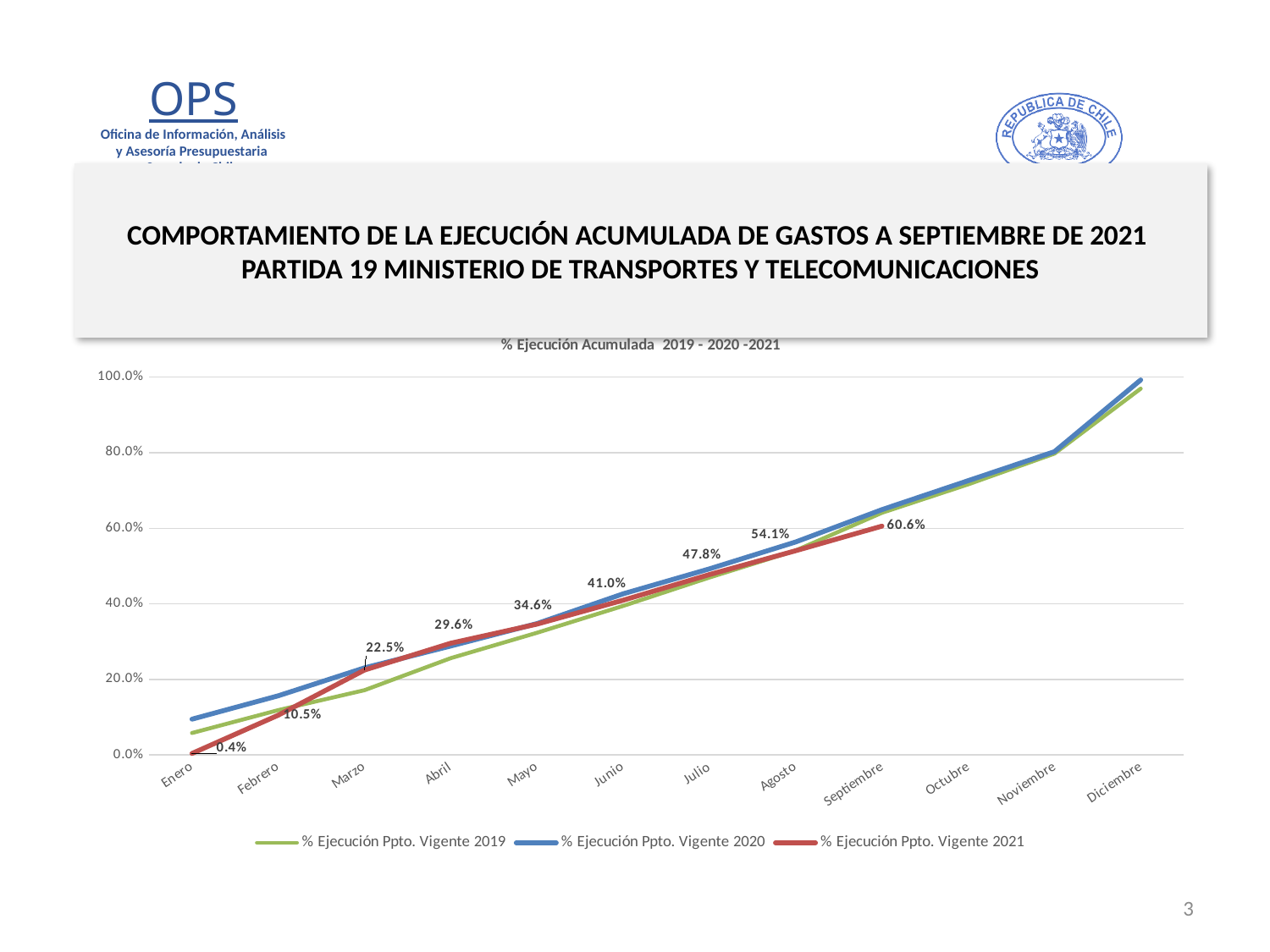
Which month has the lowest value for % Ejecución Ppto. Vigente 2021? Enero What is the value for % Ejecución Ppto. Vigente 2021 in Julio? 47.8% What is the value for % Ejecución Ppto. Vigente 2021 in Mayo? 34.6% What is the value for % Ejecución Ppto. Vigente 2021 in Septiembre? 60.6% What is the difference between the % Ejecución Ppto. Vigente 2021 values for Agosto and Julio? 6.3% What is the value for % Ejecución Ppto. Vigente 2021 in Enero? 0.4% Which month has the highest value for % Ejecución Ppto. Vigente 2021? Septiembre Do the values for % Ejecución Ppto. Vigente 2021 rise or fall from Enero to Septiembre? rise In Enero, which series is larger: % Ejecución Ppto. Vigente 2020 or % Ejecución Ppto. Vigente 2021? % Ejecución Ppto. Vigente 2020 What is the difference between the % Ejecución Ppto. Vigente 2021 values for Marzo and Febrero? 12.0% How many series does the legend list? 3 Is the value for % Ejecución Ppto. Vigente 2020 in Diciembre greater or less than 80.0%? greater